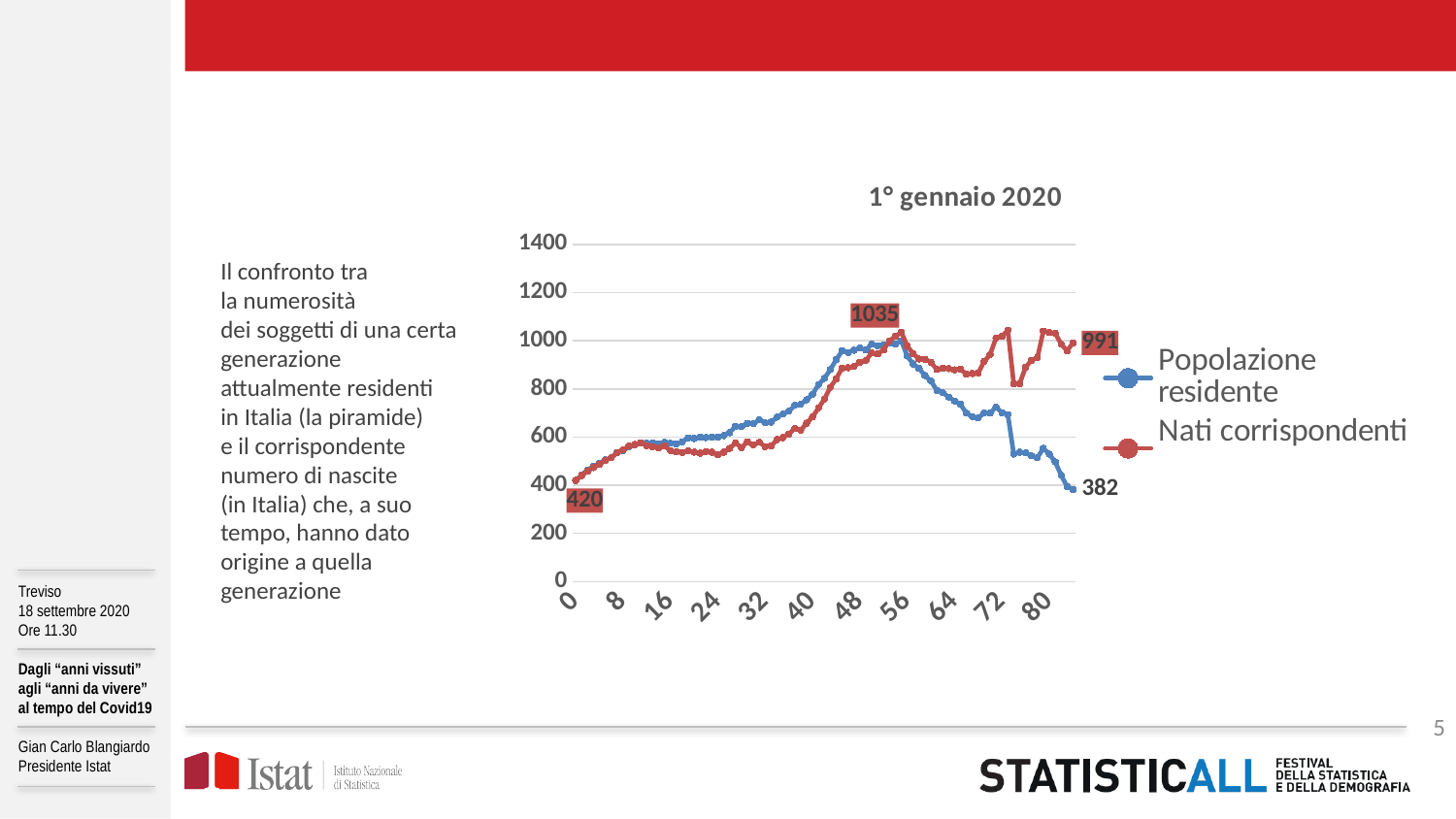
How many series does the chart legend list? 2 What is the labelled value at the right end of the Popolazione residente series? 382 At the right end of the chart, which series has the higher value: Popolazione residente or Nati corrispondenti? Nati corrispondenti What is the labelled value of Nati corrispondenti at age 0? 420 What is the difference between the final labelled values of Nati corrispondenti (991) and Popolazione residente (382)? 609 Which series is drawn in red according to the legend? Nati corrispondenti What kind of chart is shown on the slide? line chart What is the title of the chart? 1° gennaio 2020 Is the value of Popolazione residente at age 24 greater or less than 800? less What is the labelled peak value of the Nati corrispondenti series? 1035 Does the Popolazione residente series rise or fall between age 64 and age 80? fall What is the labelled value at the right end of the Nati corrispondenti series? 991